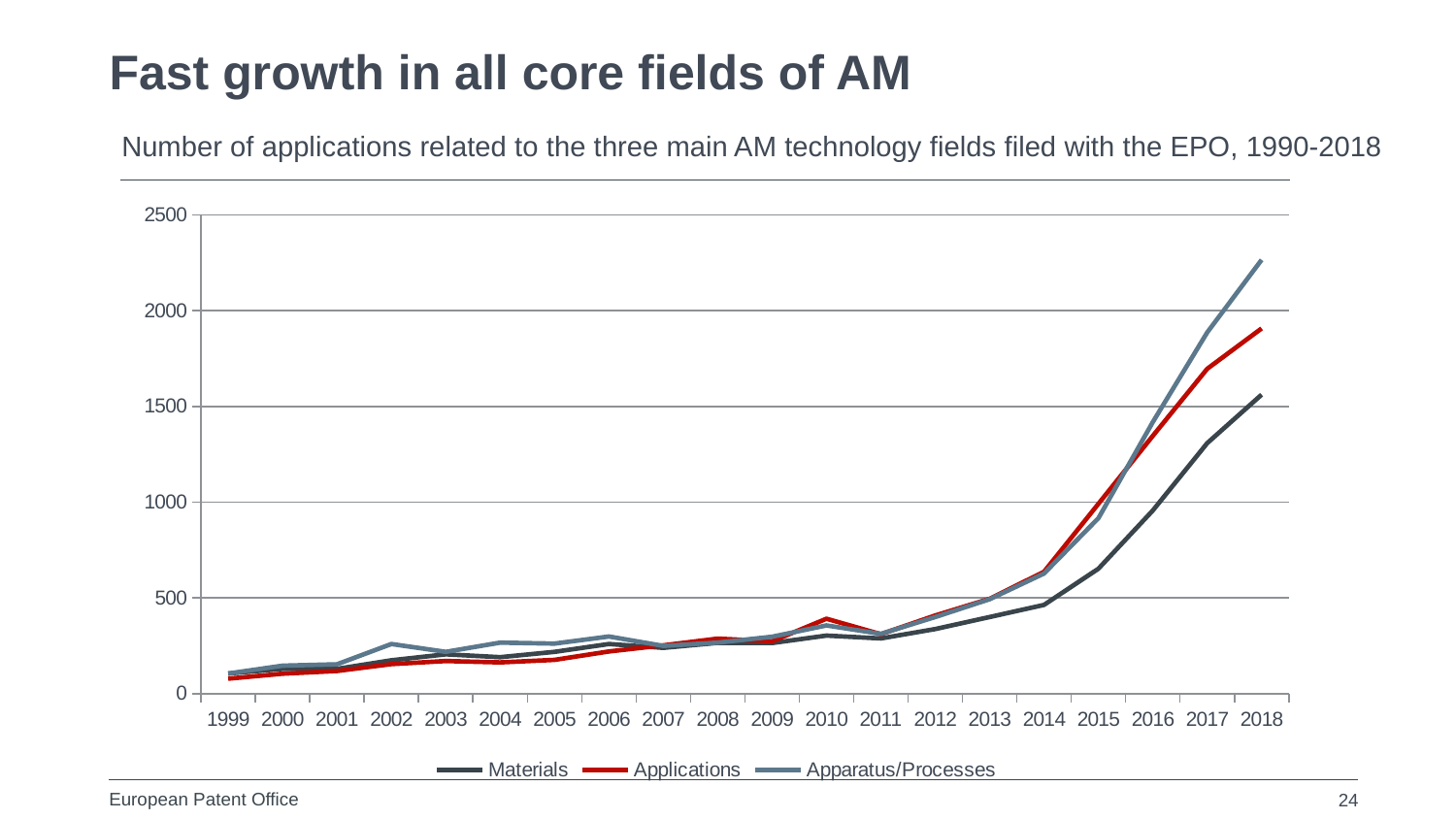
Do the values for Materials rise or fall from 2013 to 2018? rise How many series does the legend list? 3 Which series has the lowest value in 2018? Materials Is the value for Apparatus/Processes in 2018 greater or less than 2000? greater What kind of chart is shown on the slide? line chart Which series has the highest value in 2018? Apparatus/Processes How many years are shown along the x axis? 20 Is the value for Materials in 2015 greater or less than 1000? less What colour is the Applications line in the legend? red Is the value for Applications in 2018 greater or less than 1500? greater In 2018, which is larger: the value for Applications or the value for Materials? Applications